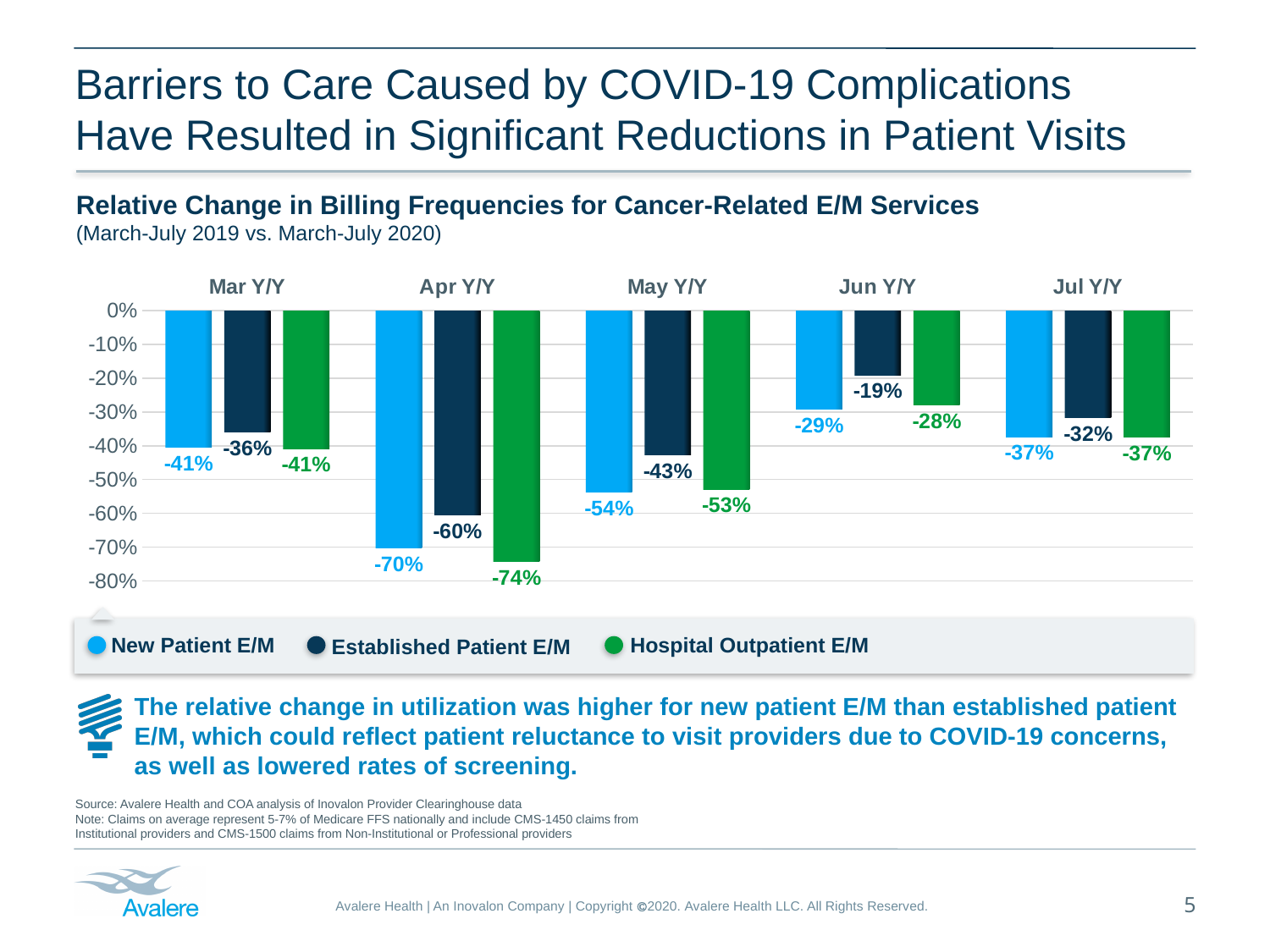
Which month shows the highest value for Established Patient E/M? Jun Y/Y Do the New Patient E/M values rise or fall from Apr Y/Y to Jun Y/Y? Rise What kind of chart is shown on the slide? Bar chart What is the value for Established Patient E/M in Jun Y/Y? -19% Which is larger in Jul Y/Y, the value for New Patient E/M or the value for Established Patient E/M? Established Patient E/M Which month shows the lowest value for Hospital Outpatient E/M? Apr Y/Y What colour represents Hospital Outpatient E/M in the legend? Green What is the difference between the New Patient E/M value and the Established Patient E/M value in Apr Y/Y? 10 percentage points How many months are shown on the x axis? 5 What is the value for Hospital Outpatient E/M in May Y/Y? -53% How many series does the legend list? 3 What is the value for New Patient E/M in Apr Y/Y? -70%